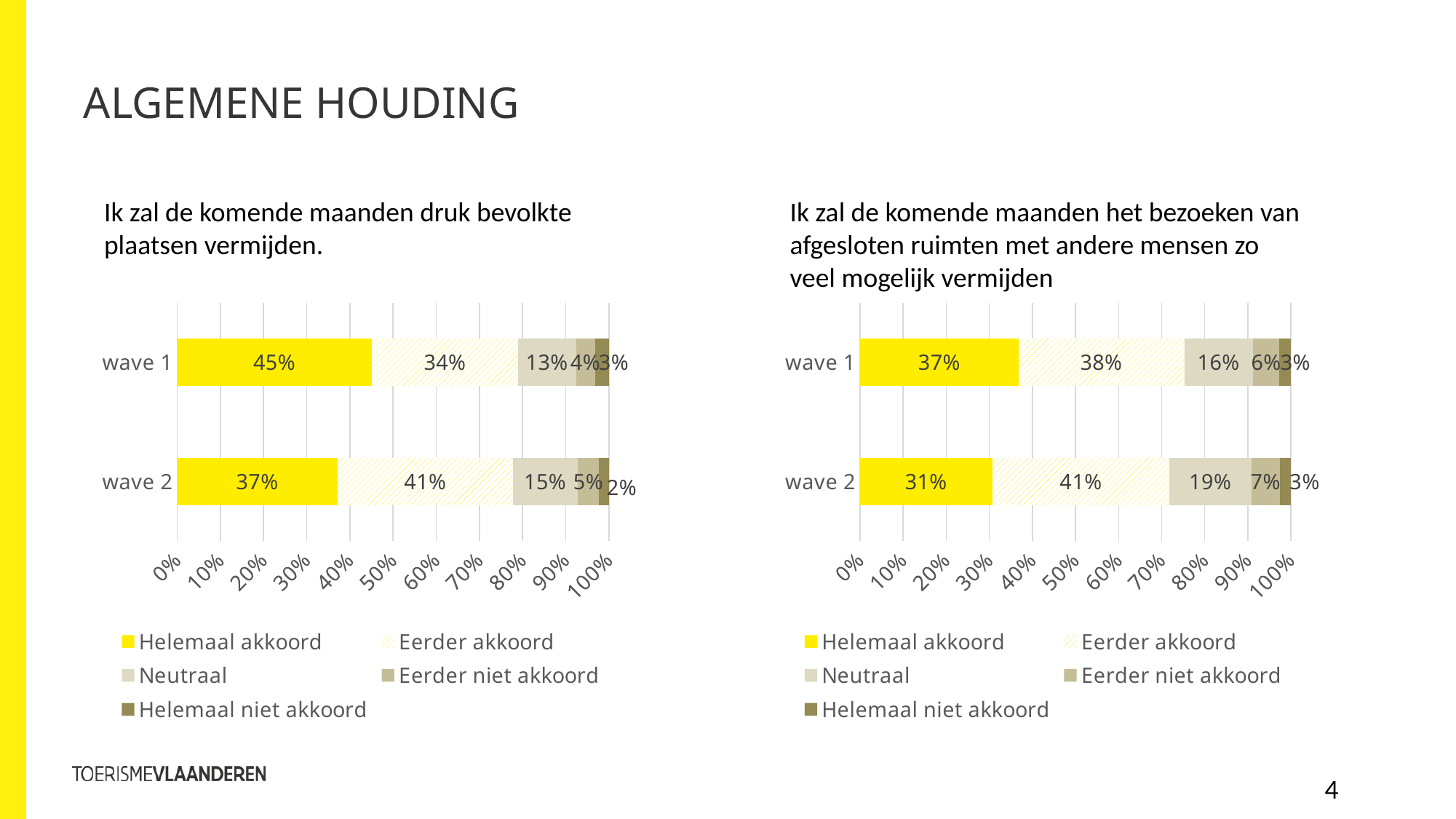
In the right chart, what percentage of wave 1 respondents answered 'Helemaal akkoord'? 37% In the left chart, which legend entry is shown in solid yellow? Helemaal akkoord In the left chart, what is the 'Eerder akkoord' value for wave 2? 41% In the left chart, by how many percentage points did 'Helemaal akkoord' change from wave 1 to wave 2? 8 percentage points How many categories (waves) are shown in the right chart? 2 In the right chart, what is the difference between the 'Eerder niet akkoord' values for wave 2 and wave 1? 1 percentage point In the left chart, which wave has the higher 'Eerder akkoord' value? wave 2 What type of chart is used on the left side of the slide? Stacked bar chart In the right chart, what is the 'Neutraal' value for wave 2? 19% In the right chart, is the 'Helemaal akkoord' value for wave 2 greater or less than 'Eerder akkoord' for wave 2? less How many series does the legend of the left chart list? 5 In the left chart, what percentage of wave 1 respondents answered 'Helemaal akkoord'? 45%